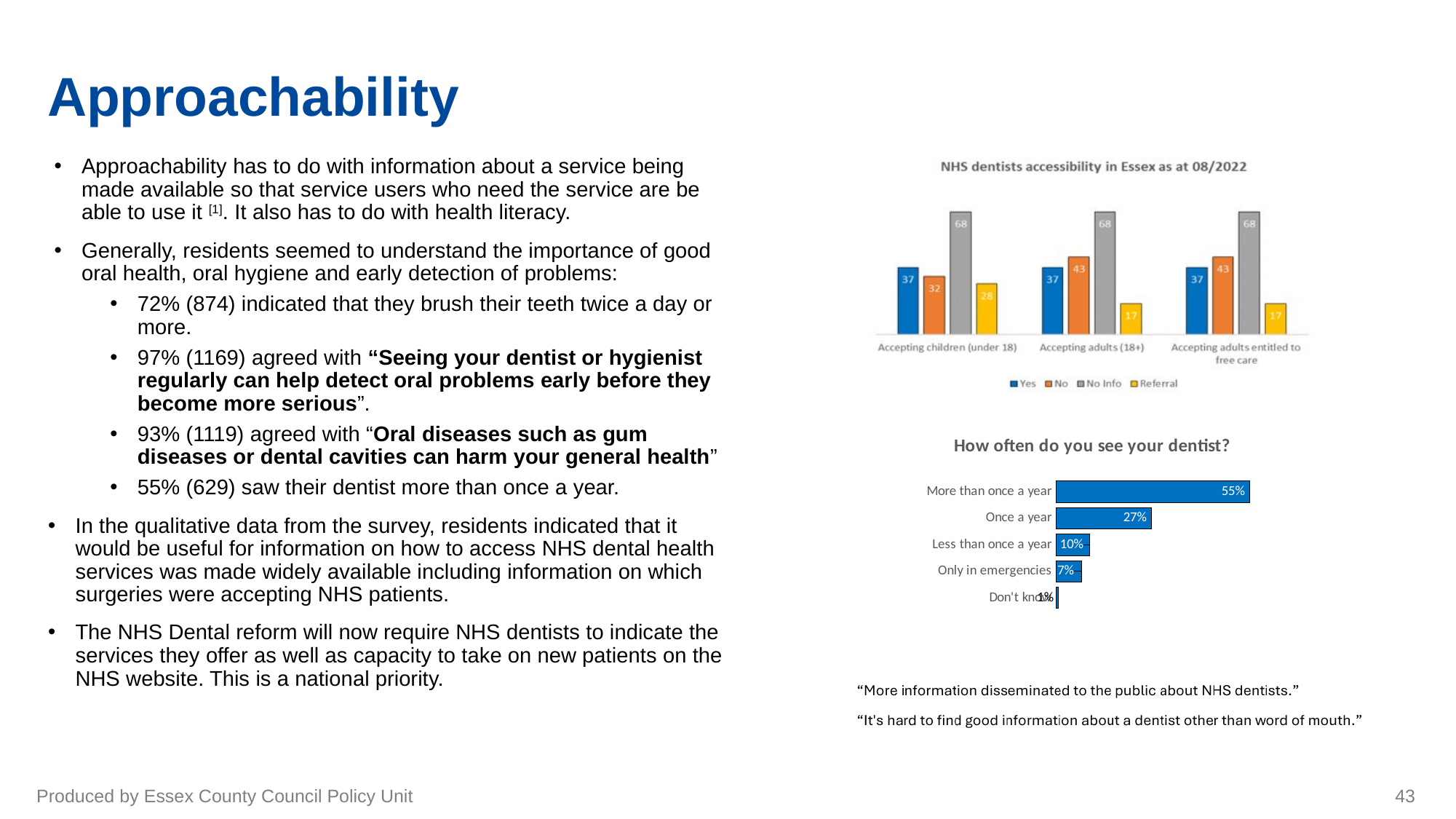
In the 'How often do you see your dentist?' chart, what is the value for 'Once a year'? 27% In the 'NHS dentists accessibility in Essex as at 08/2022' chart, how many categories are shown on the x axis? 3 In the 'NHS dentists accessibility in Essex as at 08/2022' chart, how many series does the legend list? 4 In the 'How often do you see your dentist?' chart, which category has the highest value? More than once a year In the 'How often do you see your dentist?' chart, what is the difference between 'More than once a year' and 'Less than once a year'? 45% In the 'NHS dentists accessibility in Essex as at 08/2022' chart, what is the 'No Info' value for 'Accepting children (under 18)'? 68 In the 'NHS dentists accessibility in Essex as at 08/2022' chart, what is the difference between the 'No' and 'Yes' values for 'Accepting adults (18+)'? 6 In the 'NHS dentists accessibility in Essex as at 08/2022' chart, which series has the highest value for 'Accepting adults entitled to free care'? No Info In the 'NHS dentists accessibility in Essex as at 08/2022' chart, what is the 'No' value for 'Accepting children (under 18)'? 32 What kind of chart is 'How often do you see your dentist?'? Bar chart In the 'NHS dentists accessibility in Essex as at 08/2022' chart, what is the 'Referral' value for 'Accepting adults (18+)'? 17 In the 'How often do you see your dentist?' chart, which category has the lowest value? Don't know